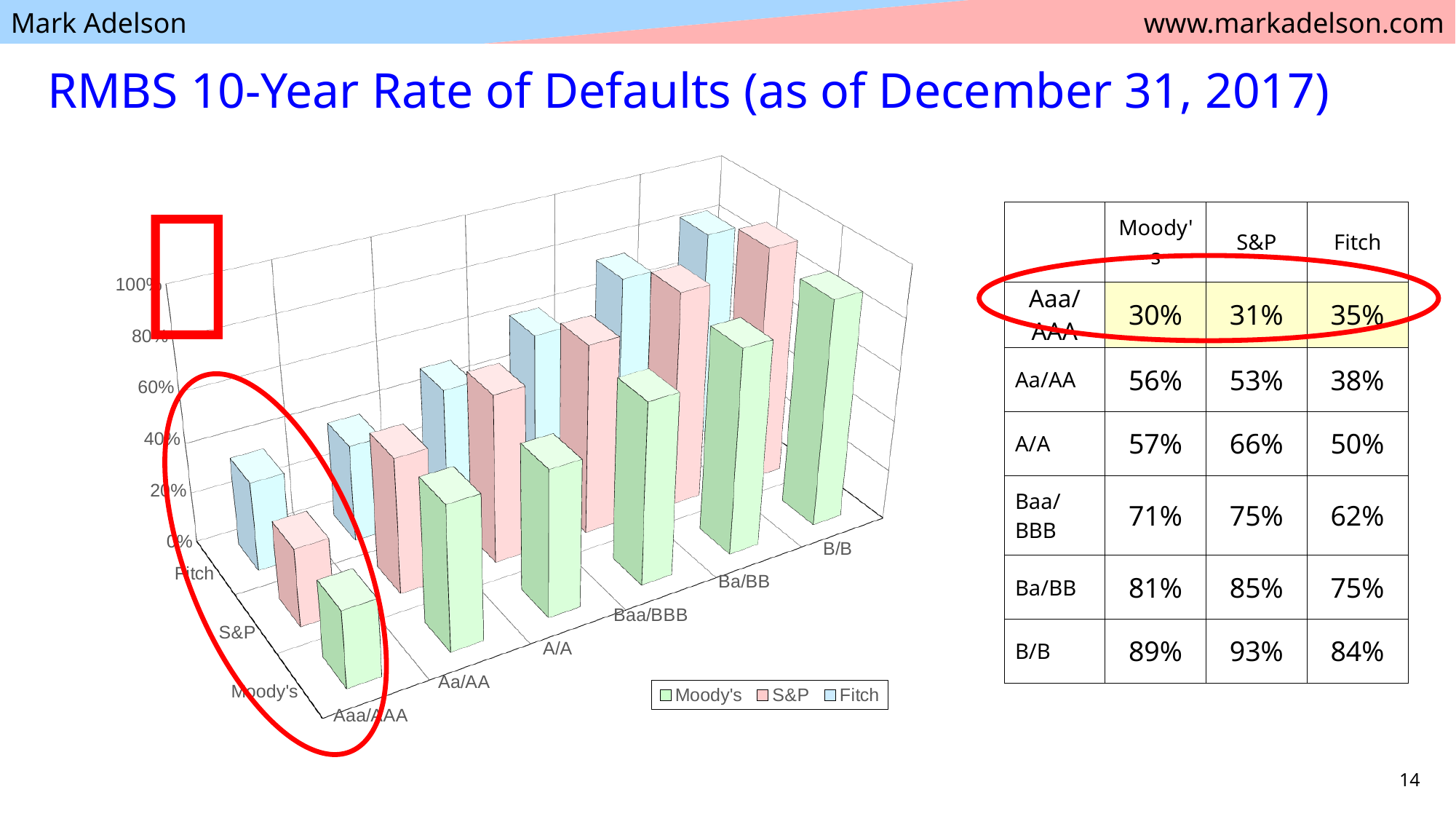
What is the Fitch 10-year default rate for the B/B category? 84% Do the default rates rise or fall as the rating categories move from Aaa/AAA to B/B? rise Which rating category has the lowest Fitch default rate? Aaa/AAA What is the difference between the S&P and Fitch default rates for the A/A category? 16% What type of chart is shown on the slide? bar chart Which rating category has the highest S&P default rate? B/B How many rating categories are plotted along the x axis of the chart? 6 How many series does the chart legend list? 3 What is the Moody's 10-year default rate for the Aaa/AAA category? 30% Which colour represents the S&P series in the chart legend? pink Which is larger for the Aa/AA category, the Moody's default rate or the Fitch default rate? Moody's What is the S&P 10-year default rate for the Baa/BBB category? 75%